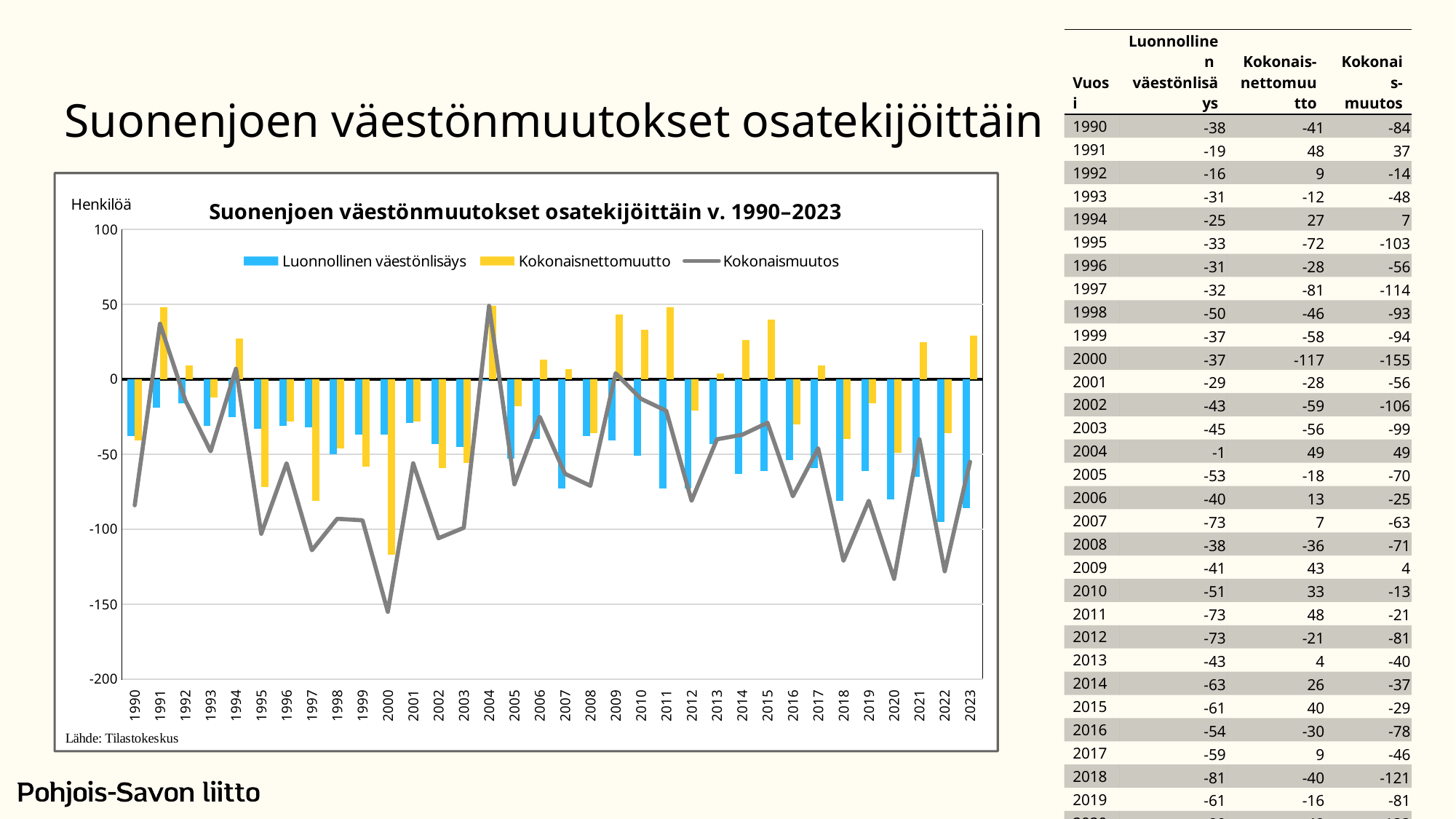
What is the Kokonaisnettomuutto value for 1991? 48 How many series does the chart legend list? 3 What is the title of the chart? Suonenjoen väestönmuutokset osatekijöittäin v. 1990–2023 Which series is drawn as a grey line in the chart? Kokonaismuutos Which is larger, the Kokonaismuutos value for 1991 or for 1994? 1991 In which year is the Kokonaismuutos line at its lowest? 2000 Is the Kokonaismuutos value for 2000 greater or less than -150? less Do the Luonnollinen väestönlisäys bars generally rise or fall from 1990 to 2023? fall In which year does the Kokonaismuutos line reach its highest value? 2004 What kind of chart is shown on the slide? A combined bar and line chart Is the Kokonaisnettomuutto value for 2000 greater or less than -100? less How many years are plotted along the x axis of the chart? 34